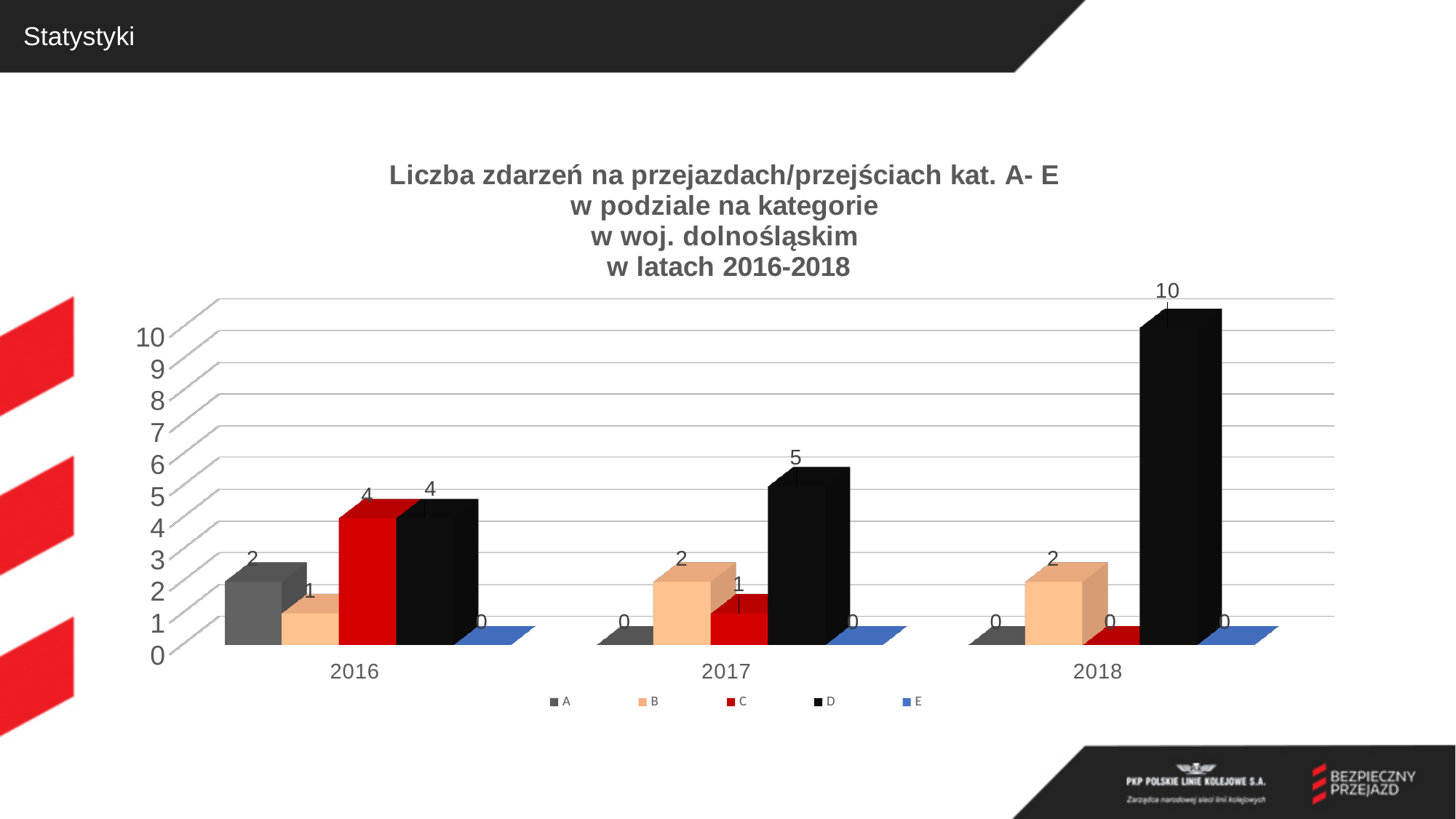
In which year is the value for series D the highest? 2018 How many series does the legend list? 5 Which is larger: the value for series A in 2016 or the value for series B in 2016? A in 2016 What type of chart is shown on the slide? bar chart What is the value for series A in 2016? 2 Does the value for series D rise or fall from 2016 to 2018? rise How many years are shown on the x axis? 3 What is the value for series B in 2017? 2 What is the difference between the value for series D in 2018 and the value for series D in 2017? 5 What is the value for series D in 2018? 10 What is the value for series C in 2016? 4 What is the value for series E in 2017? 0